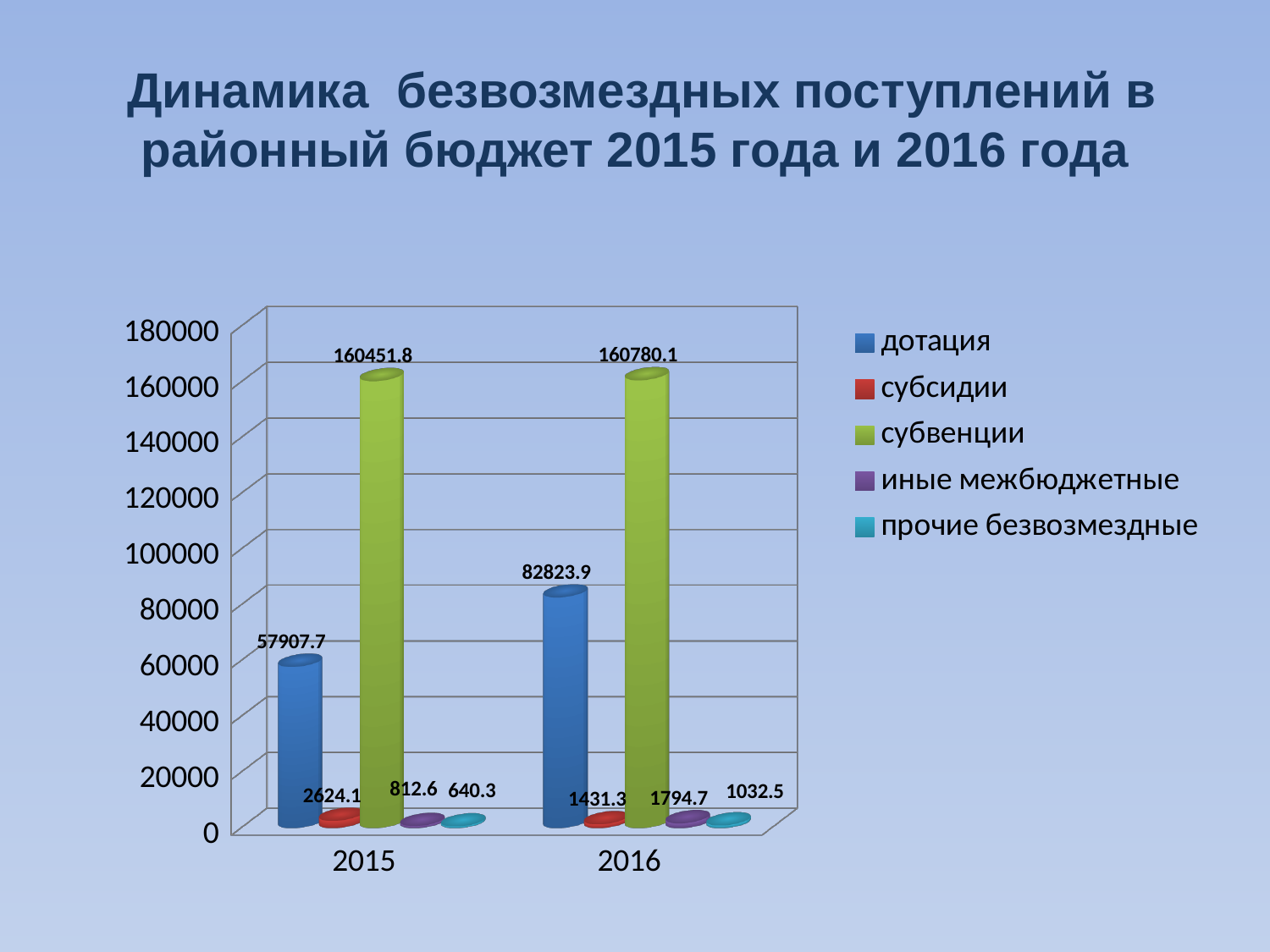
What is the value of субвенции for 2016? 160780.1 Which series has the lowest value in 2015? прочие безвозмездные Is the value of дотация for 2015 greater or less than 60000? less Which is larger, дотация in 2015 or дотация in 2016? дотация in 2016 What is the value of субсидии for 2015? 2624.1 How many series does the legend list? 5 What kind of chart is shown on the slide? bar chart What is the value of прочие безвозмездные for 2016? 1032.5 What is the difference between the дотация values for 2016 and 2015? 24916.2 How many years are shown on the x axis? 2 Which series has the highest value in 2016? субвенции What is the value of дотация for 2015? 57907.7